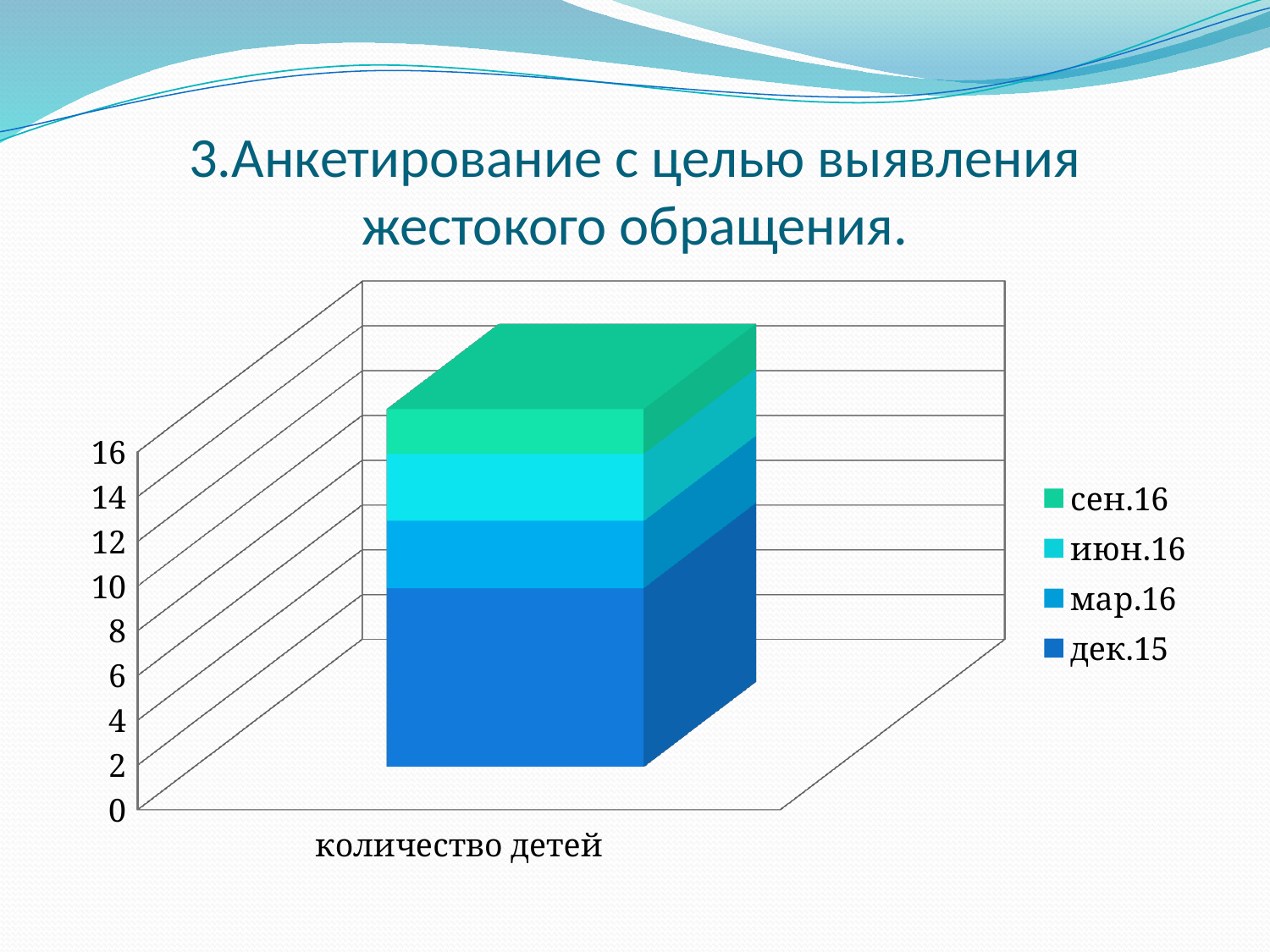
Which segment is larger, дек.15 or мар.16? дек.15 Which series is listed last in the legend? дек.15 Is the total height of the stacked bar greater or less than 12? greater What is the label of the category on the x axis? количество детей What is the highest value shown on the vertical axis? 16 Is the value for дек.15 greater or less than 6? greater How many categories are plotted on the x axis? 1 How many series does the legend list? 4 Which series forms the largest segment of the stacked bar? дек.15 What kind of chart is shown on the slide? stacked bar chart Which segment is larger, дек.15 or сен.16? дек.15 Is the value for сен.16 greater or less than 4? less